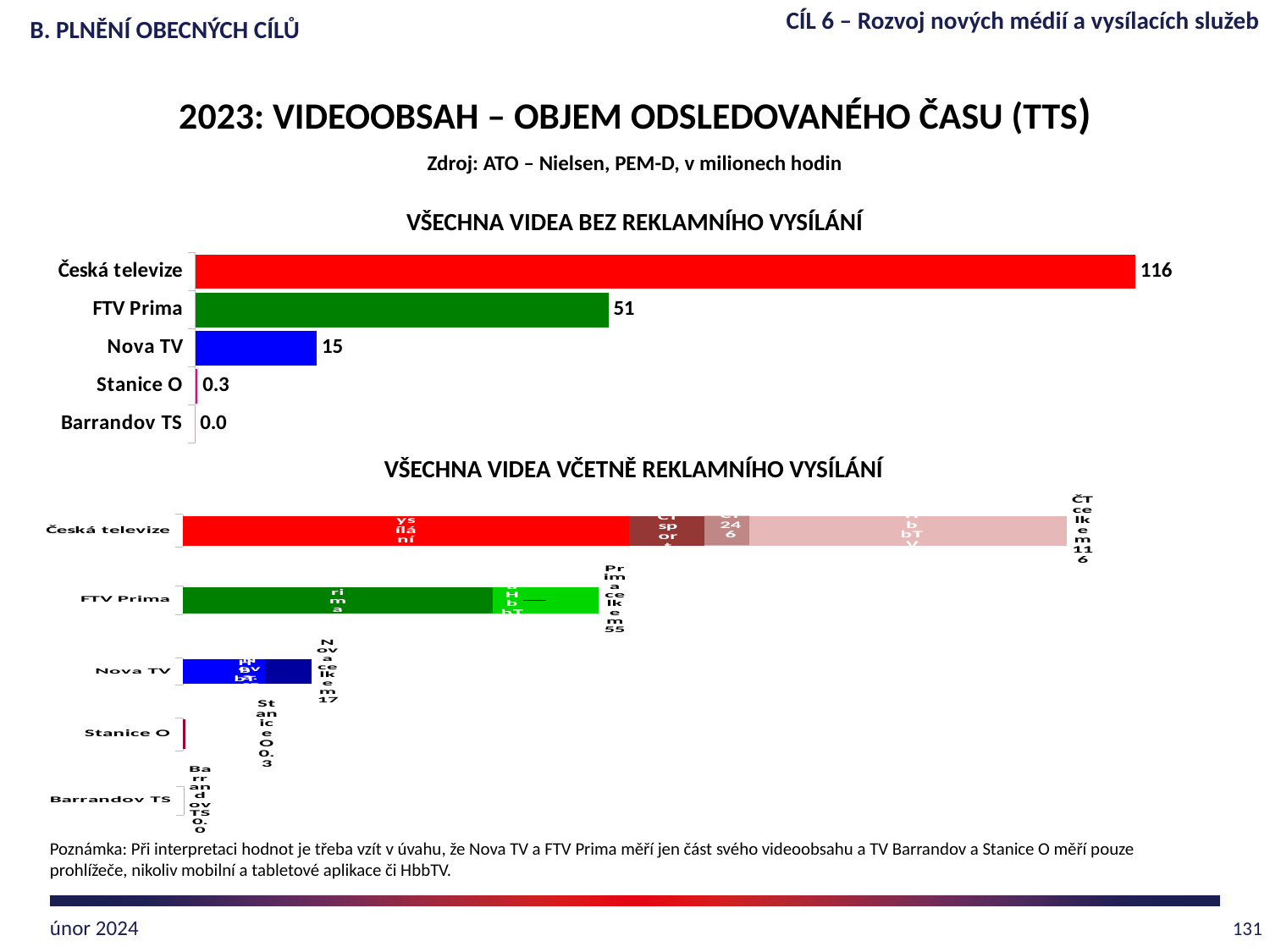
In the chart 'VŠECHNA VIDEA BEZ REKLAMNÍHO VYSÍLÁNÍ', what is the value for Česká televize? 116 In the chart 'VŠECHNA VIDEA BEZ REKLAMNÍHO VYSÍLÁNÍ', which category has the highest value? Česká televize In the chart 'VŠECHNA VIDEA BEZ REKLAMNÍHO VYSÍLÁNÍ', which is larger, the value for FTV Prima or the value for Nova TV? FTV Prima In the chart 'VŠECHNA VIDEA BEZ REKLAMNÍHO VYSÍLÁNÍ', which category has the lowest value? Barrandov TS In the chart 'VŠECHNA VIDEA BEZ REKLAMNÍHO VYSÍLÁNÍ', what is the value for Nova TV? 15 In the chart 'VŠECHNA VIDEA VČETNĚ REKLAMNÍHO VYSÍLÁNÍ', what is the total shown for FTV Prima (Prima celkem)? 55 How many categories are shown in the chart 'VŠECHNA VIDEA BEZ REKLAMNÍHO VYSÍLÁNÍ'? 5 In the chart 'VŠECHNA VIDEA VČETNĚ REKLAMNÍHO VYSÍLÁNÍ', what is the total shown for Nova TV (Nova celkem)? 17 In the chart 'VŠECHNA VIDEA BEZ REKLAMNÍHO VYSÍLÁNÍ', what is the difference between the values for Česká televize and FTV Prima? 65 What kind of chart is 'VŠECHNA VIDEA BEZ REKLAMNÍHO VYSÍLÁNÍ'? Bar chart In the chart 'VŠECHNA VIDEA BEZ REKLAMNÍHO VYSÍLÁNÍ', what is the value for Stanice O? 0.3 In the chart 'VŠECHNA VIDEA BEZ REKLAMNÍHO VYSÍLÁNÍ', what is the value for FTV Prima? 51